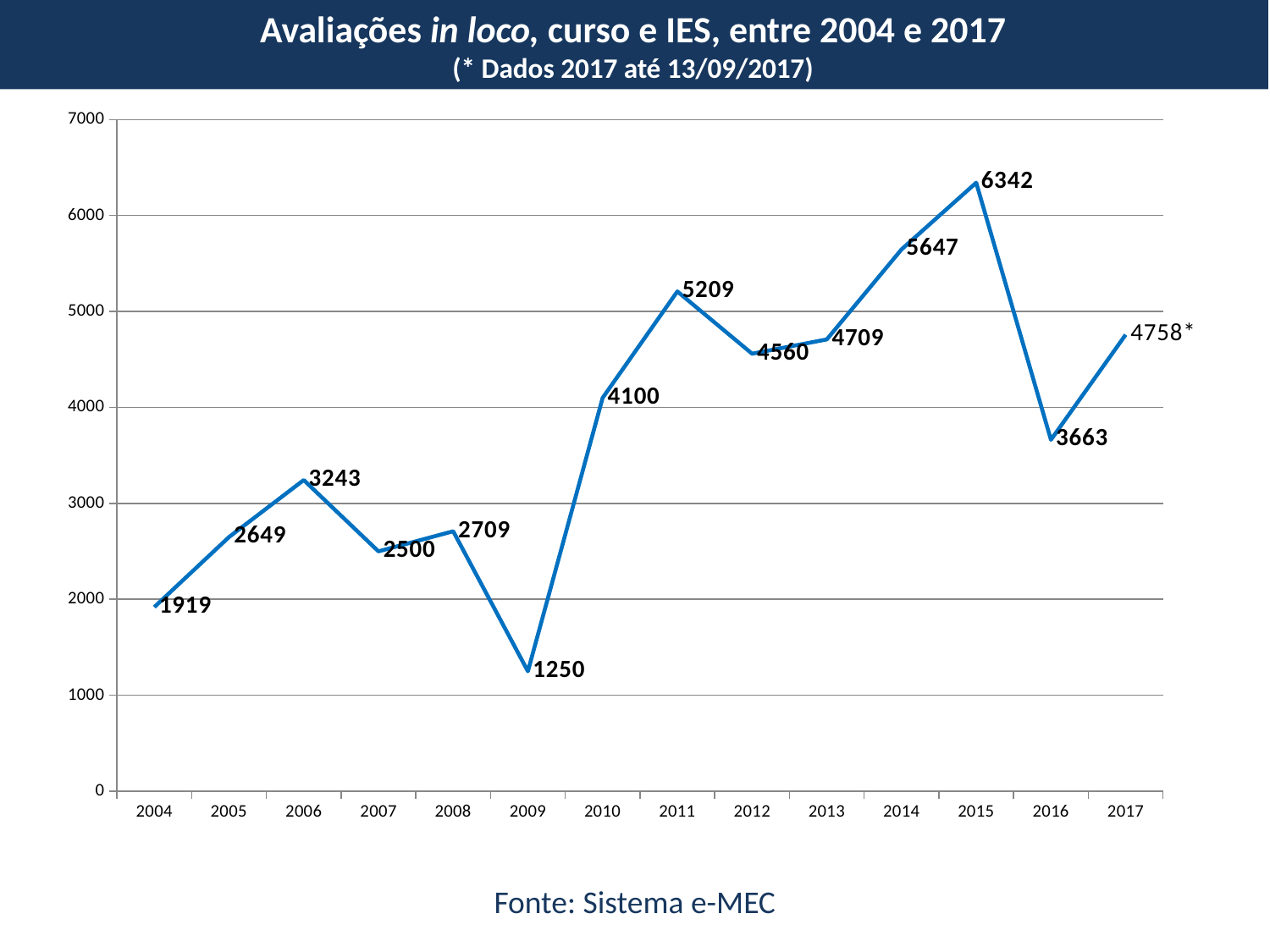
What kind of chart is shown? Line chart What is the difference between the values for 2015 and 2016? 2679 What is the value for 2004? 1919 Which year has the highest value? 2015 What is the value for 2015? 6342 Which year has the lowest value? 2009 Which is larger, the value for 2011 or the value for 2014? 2014 How many years are plotted on the x axis? 14 What source is cited below the chart? Sistema e-MEC What is the value for 2009? 1250 Do the values rise or fall from 2009 to 2011? Rise What is the value for 2017, as labelled on the chart? 4758*